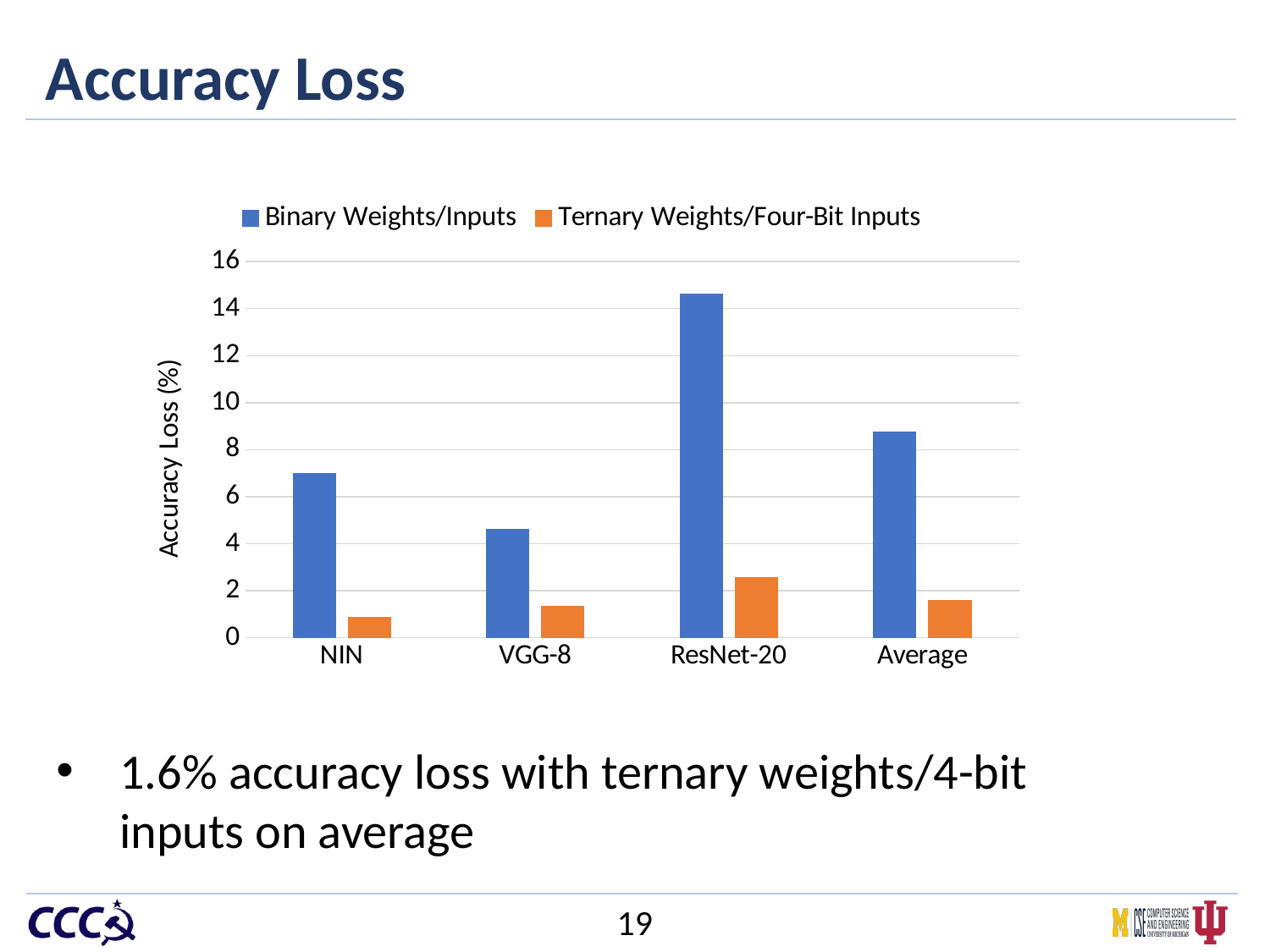
Which category has the lowest Binary Weights/Inputs accuracy loss? VGG-8 What is the label of the y axis? Accuracy Loss (%) Which category has the highest Ternary Weights/Four-Bit Inputs accuracy loss? ResNet-20 Is the Binary Weights/Inputs value for ResNet-20 greater or less than 12? greater How many categories are shown on the x axis? 4 Which category has the lowest Ternary Weights/Four-Bit Inputs accuracy loss? NIN Is the Ternary Weights/Four-Bit Inputs value for VGG-8 greater or less than 2? less Which colour represents the Ternary Weights/Four-Bit Inputs series? orange What kind of chart is shown on the slide? bar chart For ResNet-20, which series has the larger accuracy loss, Binary Weights/Inputs or Ternary Weights/Four-Bit Inputs? Binary Weights/Inputs How many series does the legend list? 2 Which category has the highest Binary Weights/Inputs accuracy loss? ResNet-20